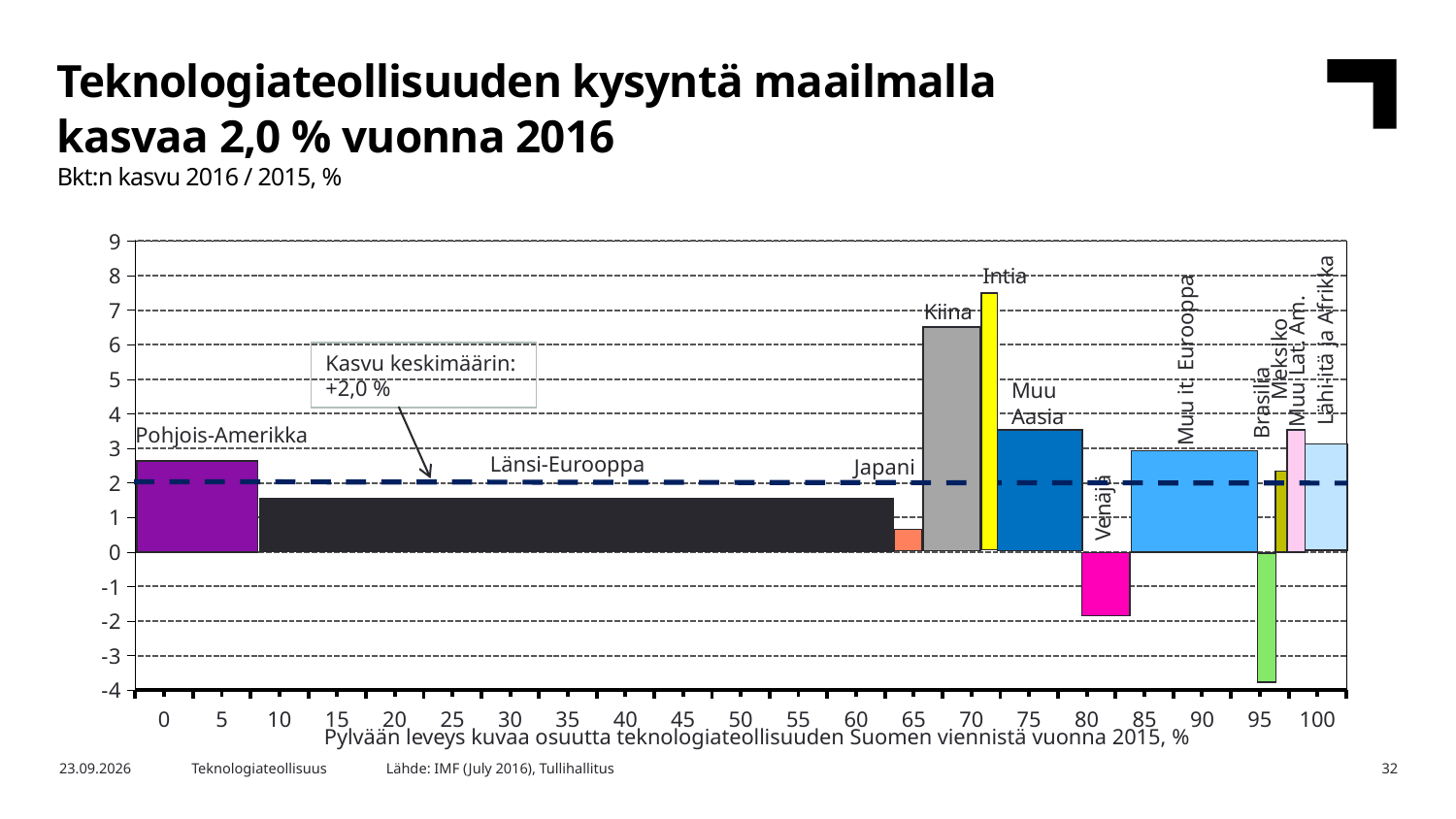
Is the value for Pohjois-Amerikka greater or less than 2? greater Which has the larger value, Kiina or Muu Aasia? Kiina Is the value for Venäjä greater or less than -1? less What kind of chart is shown on the slide? bar chart What average growth value is shown by the dashed line annotation in the chart? +2,0 % How many regions are plotted as bars in the chart? 12 Is the value for Japani greater or less than 1? less Which region has the lowest GDP growth value in the chart? Brasilia Which has the larger value, Pohjois-Amerikka or Länsi-Eurooppa? Pohjois-Amerikka Which region has the highest GDP growth value in the chart? Intia